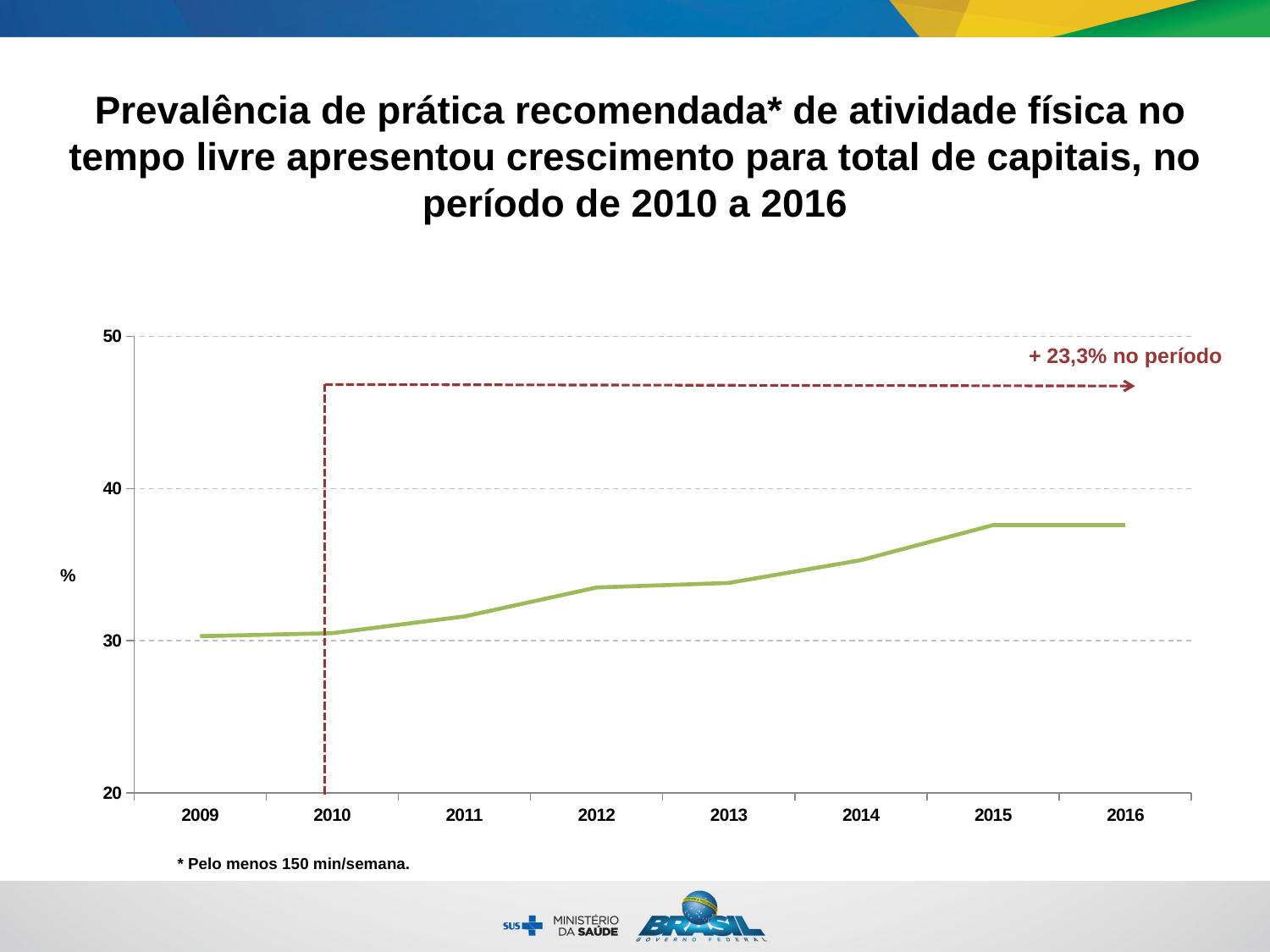
What percentage change over the period is annotated on the chart? + 23,3% no período Is the value for 2014 greater or less than 30? greater What is the label on the y axis of the chart? % Which year has the larger value, 2012 or 2015? 2015 Is the value for 2015 greater or less than 40? less Is the value for 2016 greater or less than 40? less Which year has the larger value, 2009 or 2016? 2016 What kind of chart is shown on the slide? line chart Do the values on the chart rise or fall from 2009 to 2016? rise How many years are shown along the x axis of the chart? 8